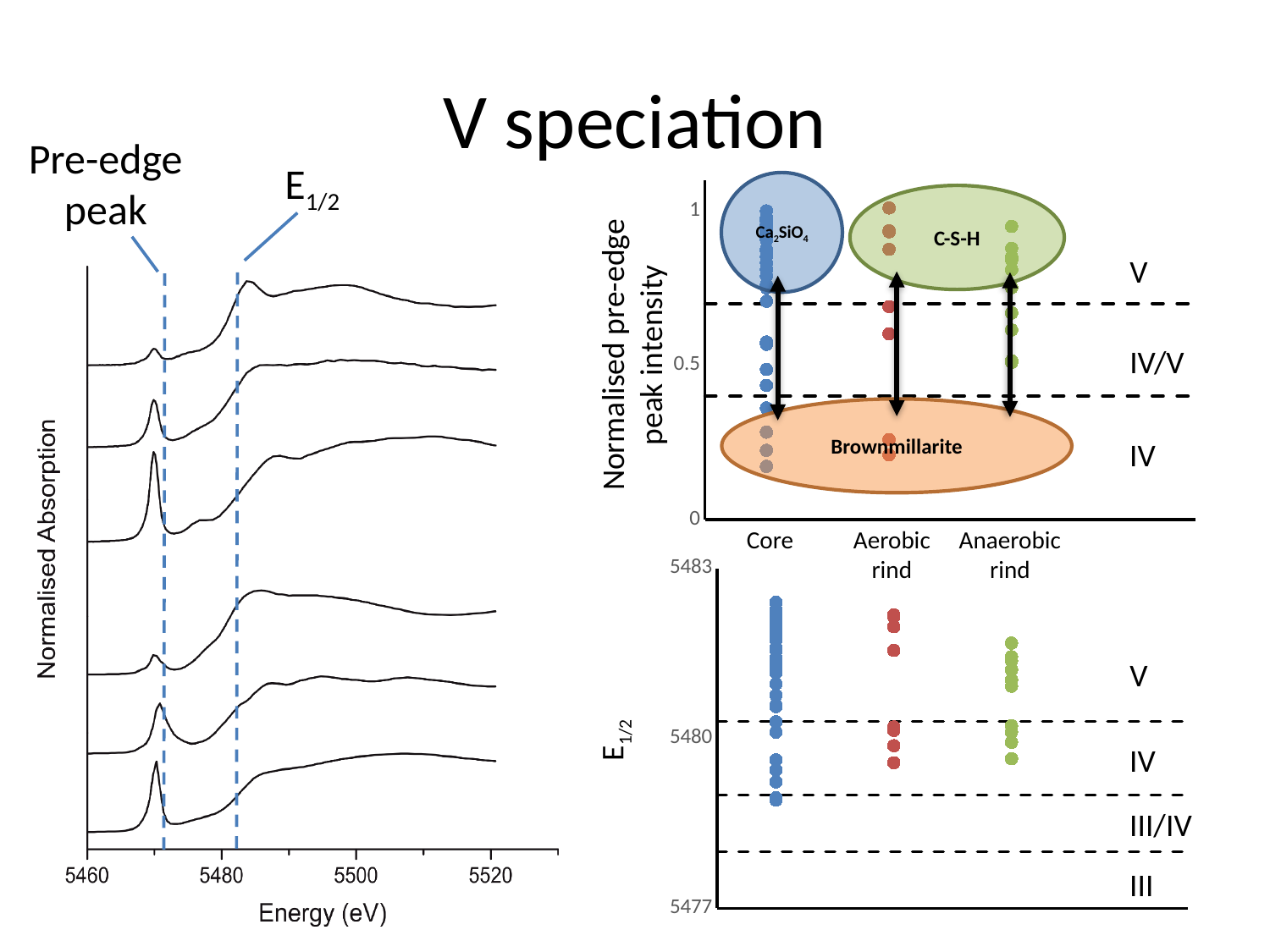
On the bottom-right chart of E1/2, what is the lowest tick value on the y axis? 5477 On the top-right chart of normalised pre-edge peak intensity, is the highest Core point greater or less than 0.5? greater On the top-right chart of normalised pre-edge peak intensity, which oxidation state label is shown at the top of the chart? V On the bottom-right chart of E1/2, are the Anaerobic rind points greater or less than 5483? less What kind of chart is the left-hand chart of Normalised Absorption versus Energy? line chart On the left-hand chart, which feature is marked by the left dashed vertical line? Pre-edge peak On the top-right chart of normalised pre-edge peak intensity, is the lowest Core point greater or less than 0.5? less On the top-right chart of normalised pre-edge peak intensity, what is the highest tick value on the y axis? 1 On the top-right chart of normalised pre-edge peak intensity, how many sample categories are shown on the x axis? 3 On the bottom-right chart of E1/2, what is the highest tick value on the y axis? 5483 On the left-hand chart, what is the label of the x axis? Energy (eV)